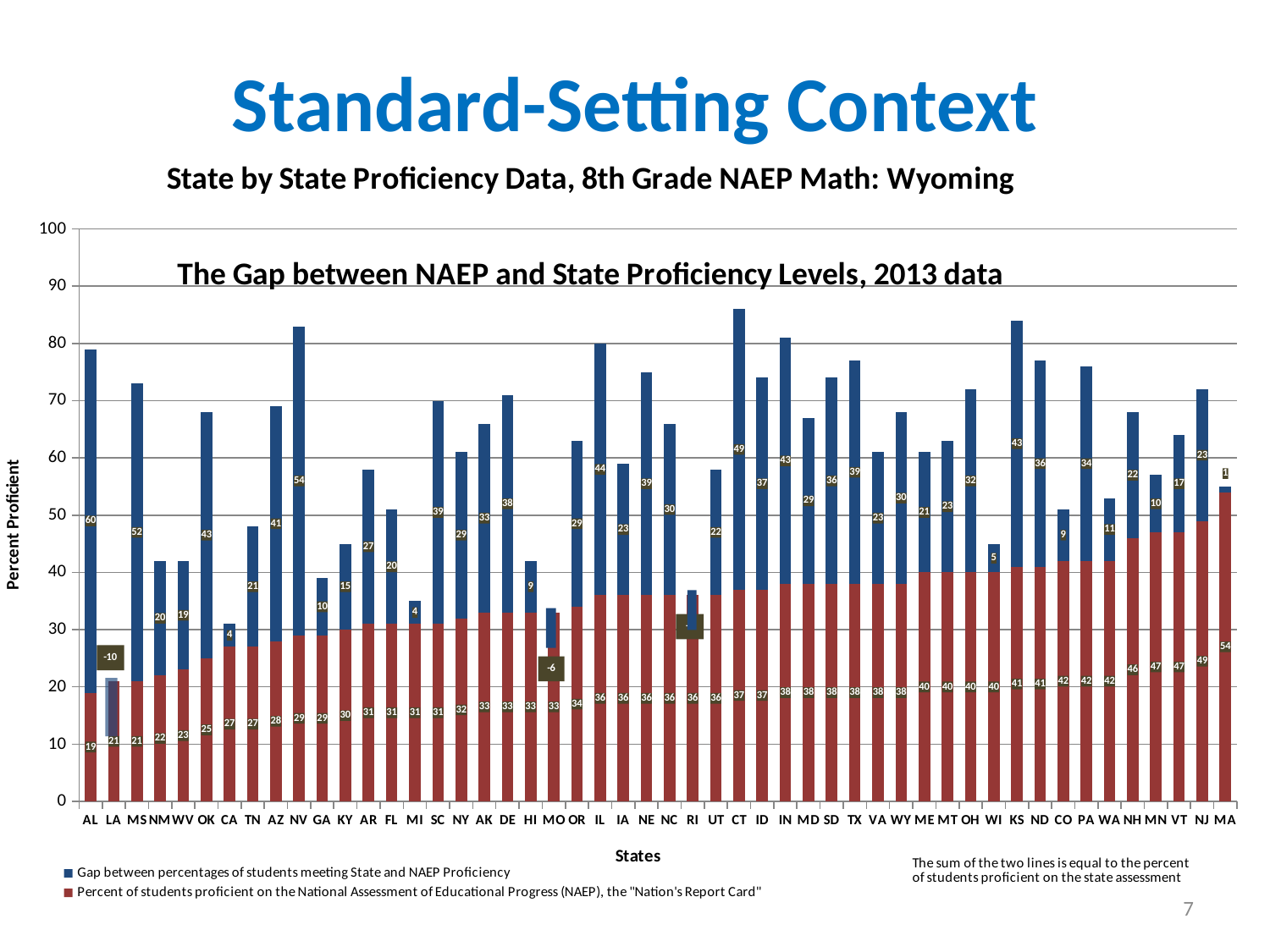
Which state has the lowest percent of students proficient on NAEP? AL What is the total height of the stacked bar for CT (NAEP percent plus gap)? 86 How many series does the legend list? 2 What kind of chart is shown on the slide? Stacked bar chart Is the total stacked bar for KS greater or less than 80? greater Which state has the largest gap between State and NAEP proficiency? AL How many states are shown along the x axis? 50 What is the percent of students proficient on NAEP for MA? 54 Which state has the highest percent of students proficient on NAEP? MA What is the total height of the stacked bar for AL (NAEP percent plus gap)? 79 What is the gap between State and NAEP proficiency for AL? 60 What is the difference between the NAEP proficiency percent for MA and for AL? 35